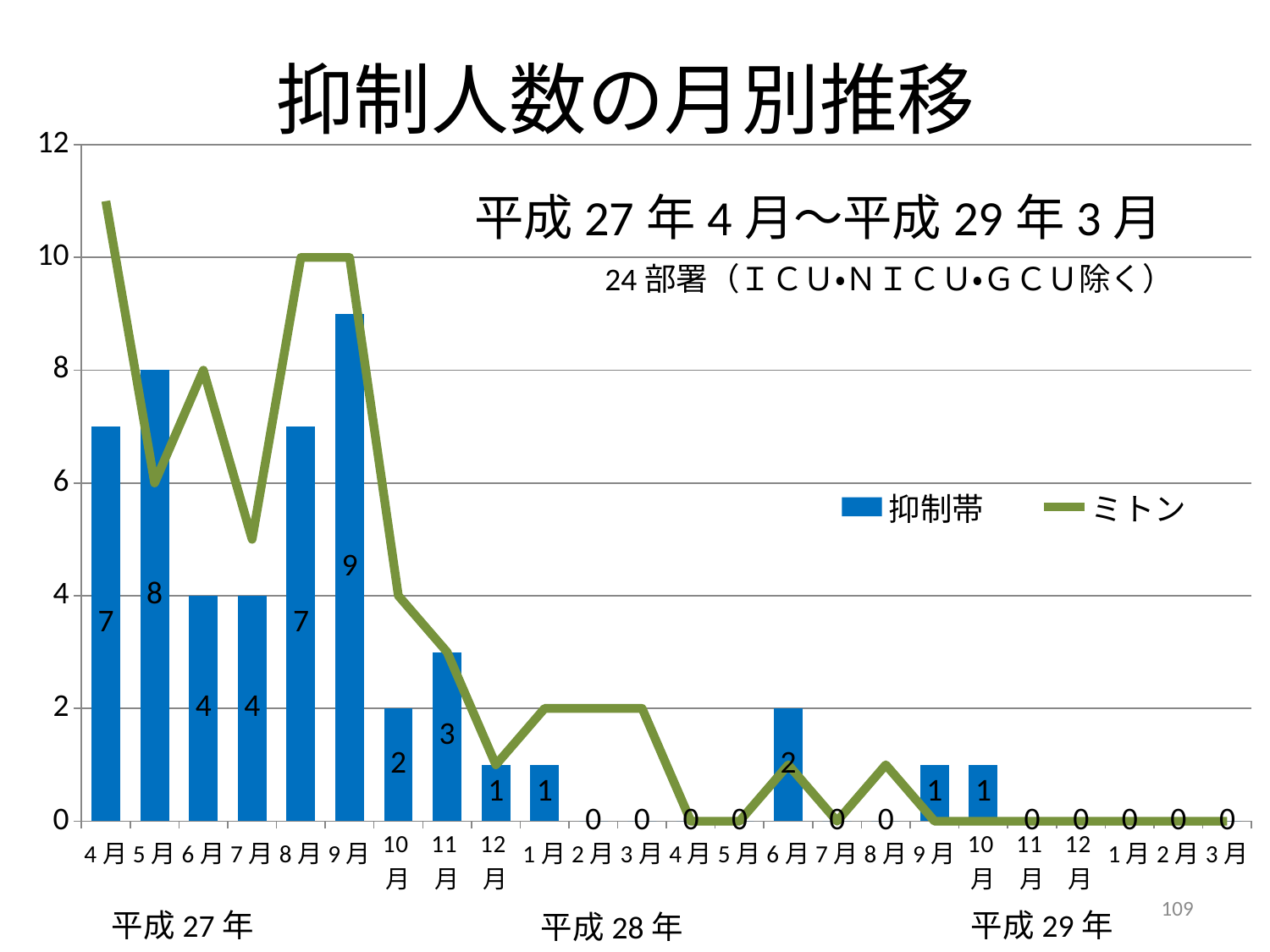
What kind of chart is this? Combined bar and line chart What is the 抑制帯 value for 平成27年9月? 9 What is the 抑制帯 value for 平成28年6月? 2 What is the difference between the 抑制帯 values for 平成27年5月 and 平成27年10月? 6 Which is larger, the 抑制帯 value for 平成27年4月 or for 平成27年6月? 平成27年4月 Is the ミトン value for 平成27年4月 greater or less than 10? greater Which month has the highest 抑制帯 value? 平成27年9月 How many months are shown on the x axis? 24 Is the ミトン value for 平成27年7月 greater or less than 6? less What is the 抑制帯 value for 平成27年11月? 3 How many series does the legend list? 2 What is the title of the chart? 抑制人数の月別推移